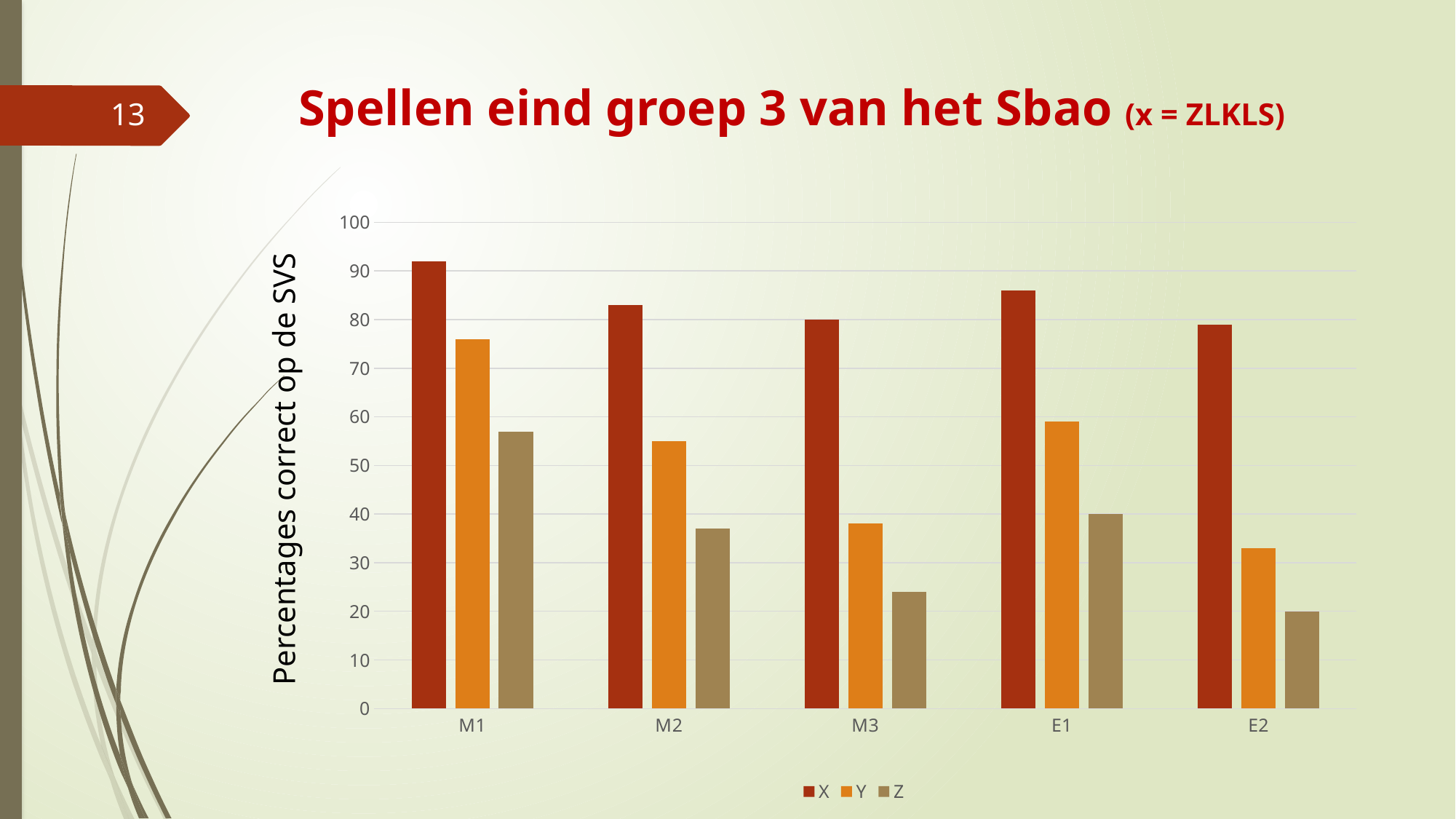
Which category has the lowest value for series Z? E2 Which is larger: the value for series X at M1 or at E1? M1 Do the values for series Z rise or fall from M1 to M3? fall Is the value for series X at M1 greater or less than 90? greater What is the label of the vertical axis? Percentages correct op de SVS Which category has the lowest value for series Y? E2 Is the value for series Z at M1 greater or less than 50? greater Which category has the highest value for series X? M1 How many categories are shown on the x axis? 5 Is the value for series Y at M3 greater or less than 40? less How many series does the legend list? 3 What kind of chart is shown on the slide? bar chart